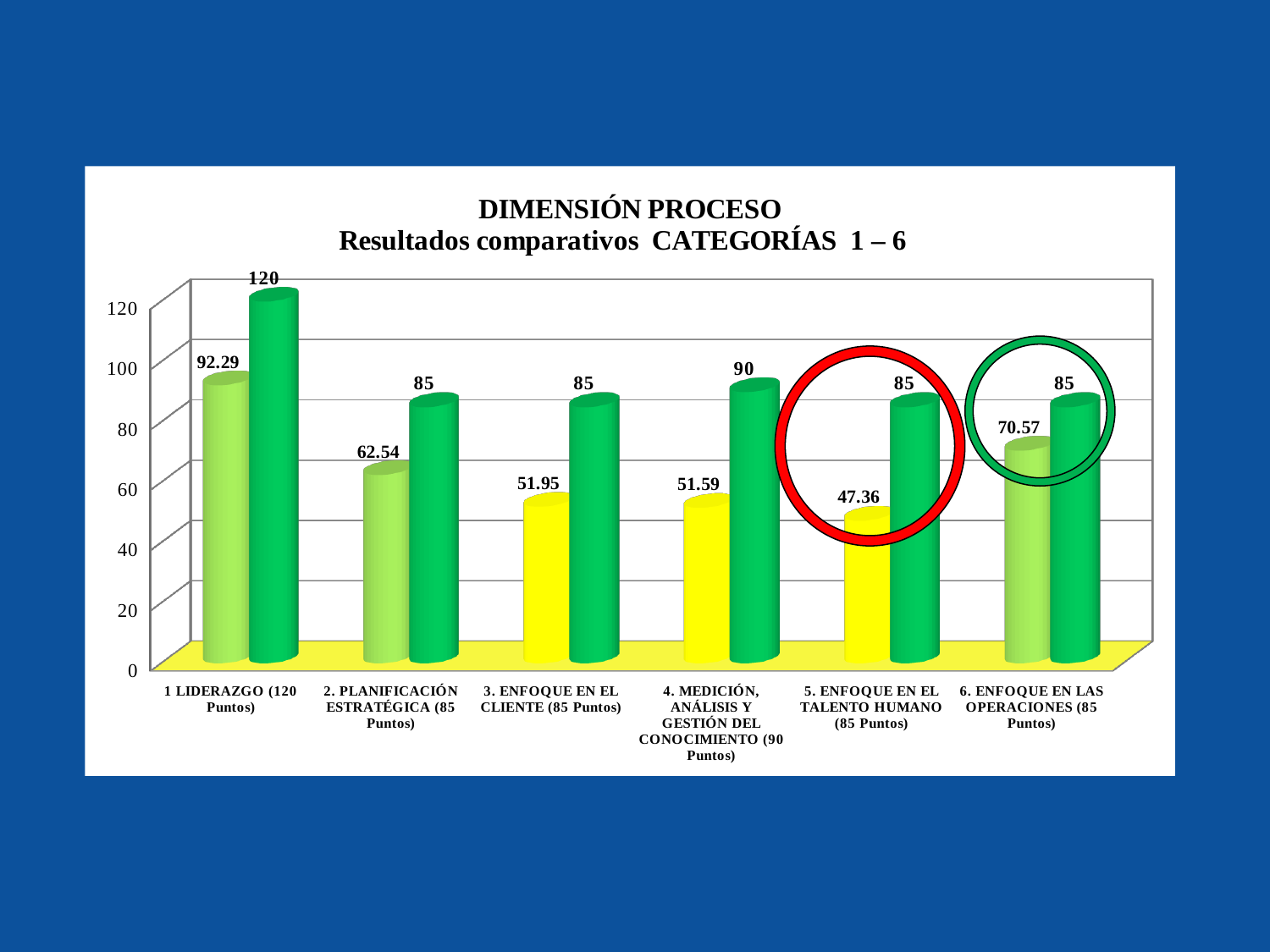
What is the achieved score shown for 6. ENFOQUE EN LAS OPERACIONES (85 Puntos)? 70.57 What is the title of the chart? DIMENSIÓN PROCESO Resultados comparativos CATEGORÍAS 1 – 6 What is the difference between the achieved scores of 6. ENFOQUE EN LAS OPERACIONES and 5. ENFOQUE EN EL TALENTO HUMANO? 23.21 How many categories are shown on the x axis? 6 Which achieved score is larger: 2. PLANIFICACIÓN ESTRATÉGICA or 3. ENFOQUE EN EL CLIENTE? 2. PLANIFICACIÓN ESTRATÉGICA What is the achieved score shown for 5. ENFOQUE EN EL TALENTO HUMANO (85 Puntos)? 47.36 Which category has the lowest achieved score? 5. ENFOQUE EN EL TALENTO HUMANO (85 Puntos) What kind of chart is shown on the slide? Bar chart What is the difference between the maximum points (120) and the achieved score for 1 LIDERAZGO? 27.71 Which category has the highest achieved score? 1 LIDERAZGO (120 Puntos) What is the achieved score shown for 1 LIDERAZGO (120 Puntos)? 92.29 What is the maximum points value shown for 4. MEDICIÓN, ANÁLISIS Y GESTIÓN DEL CONOCIMIENTO? 90